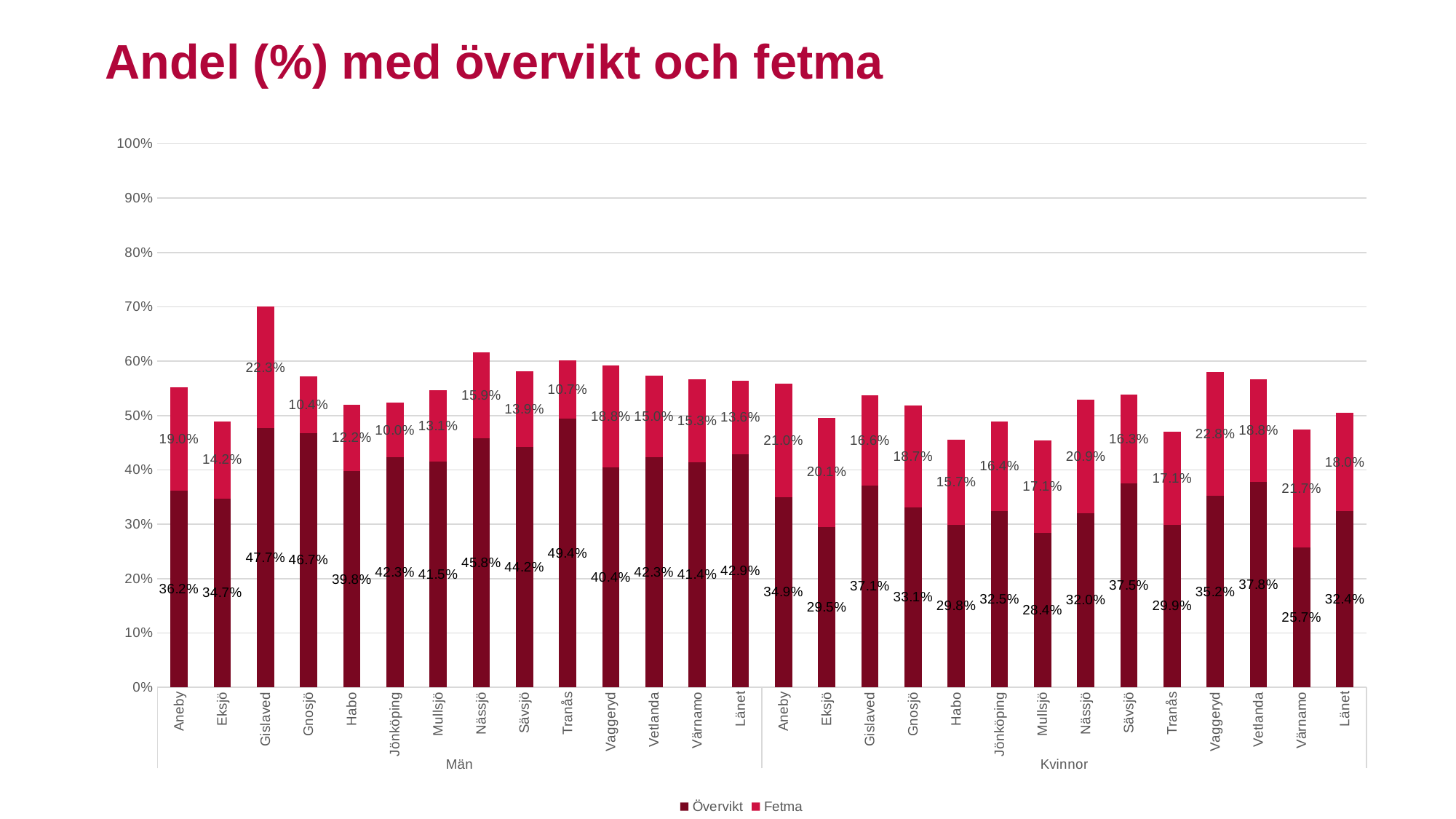
Which category in the Kvinnor group has the lowest Övervikt value? Värnamo What is the Fetma value for Värnamo in the Kvinnor group? 21.7% What kind of chart is shown on the slide? Stacked bar chart What is the difference between the Fetma values for Gislaved in the Män group and Gislaved in the Kvinnor group? 5.7% Is the total stacked value for Gislaved in the Män group greater or less than 60%? greater Which category in the Män group has the highest Övervikt value? Tranås What is the Övervikt value for Gislaved in the Män group? 47.7% What is the title of the chart? Andel (%) med övervikt och fetma Which is larger, the Övervikt value for Länet in the Män group or the Övervikt value for Länet in the Kvinnor group? Länet in the Män group How many bars are plotted in the Kvinnor group? 14 How many series does the legend list? 2 What is the total stacked value for Tranås in the Män group? 60.1%